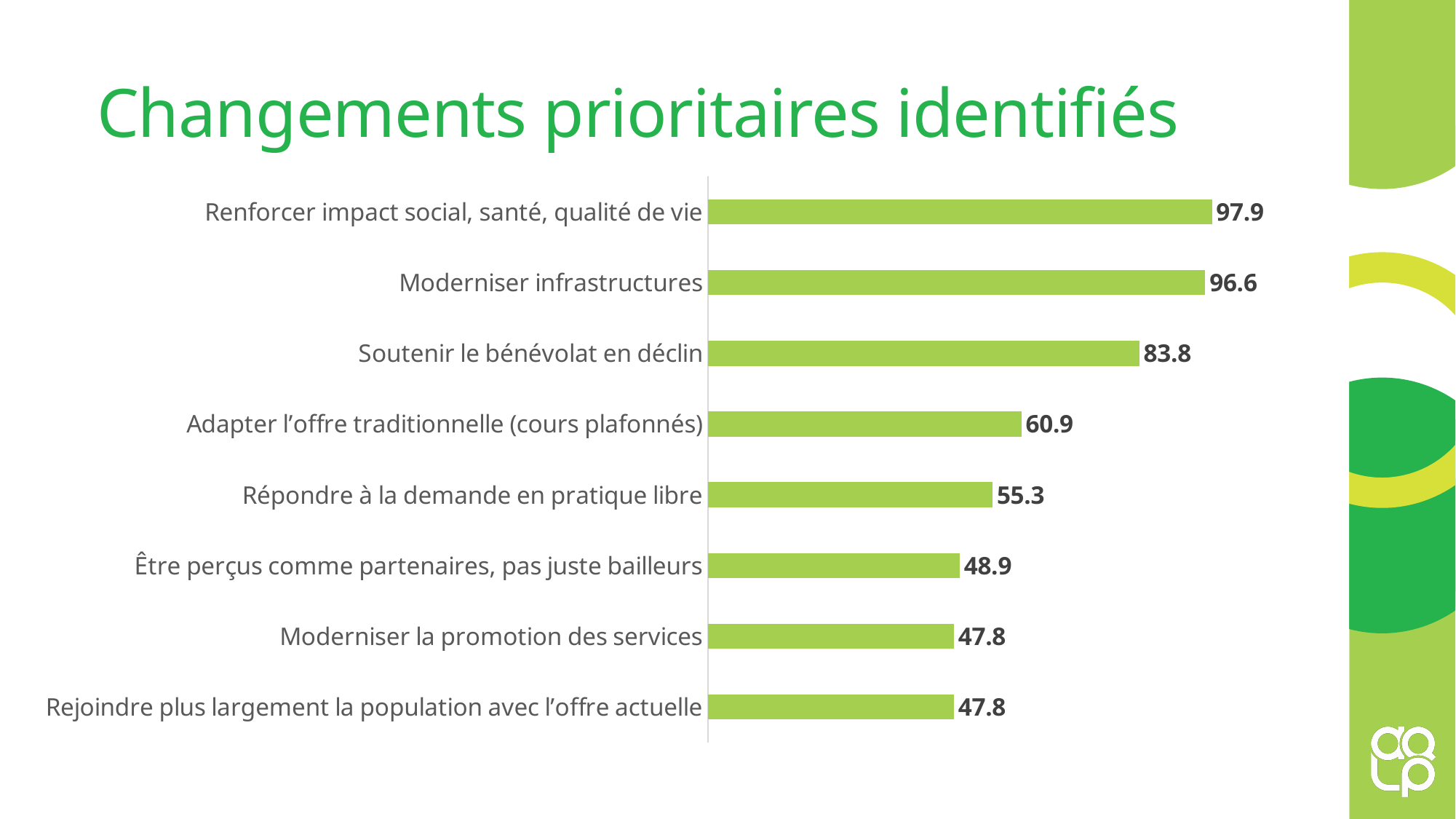
How many categories are shown on the chart? 8 What is the value for "Soutenir le bénévolat en déclin"? 83.8 Which is larger: the value for "Adapter l'offre traditionnelle (cours plafonnés)" or the value for "Être perçus comme partenaires, pas juste bailleurs"? Adapter l'offre traditionnelle (cours plafonnés) What kind of chart is shown on the slide? Bar chart What is the difference between the values for "Renforcer impact social, santé, qualité de vie" and "Adapter l'offre traditionnelle (cours plafonnés)"? 37.0 What is the title of the slide? Changements prioritaires identifiés What is the difference between the values for "Soutenir le bénévolat en déclin" and "Répondre à la demande en pratique libre"? 28.5 Which category has the highest value? Renforcer impact social, santé, qualité de vie What is the value for "Moderniser infrastructures"? 96.6 What is the value for "Répondre à la demande en pratique libre"? 55.3 What is the value for "Être perçus comme partenaires, pas juste bailleurs"? 48.9 What is the lowest value shown on the chart? 47.8